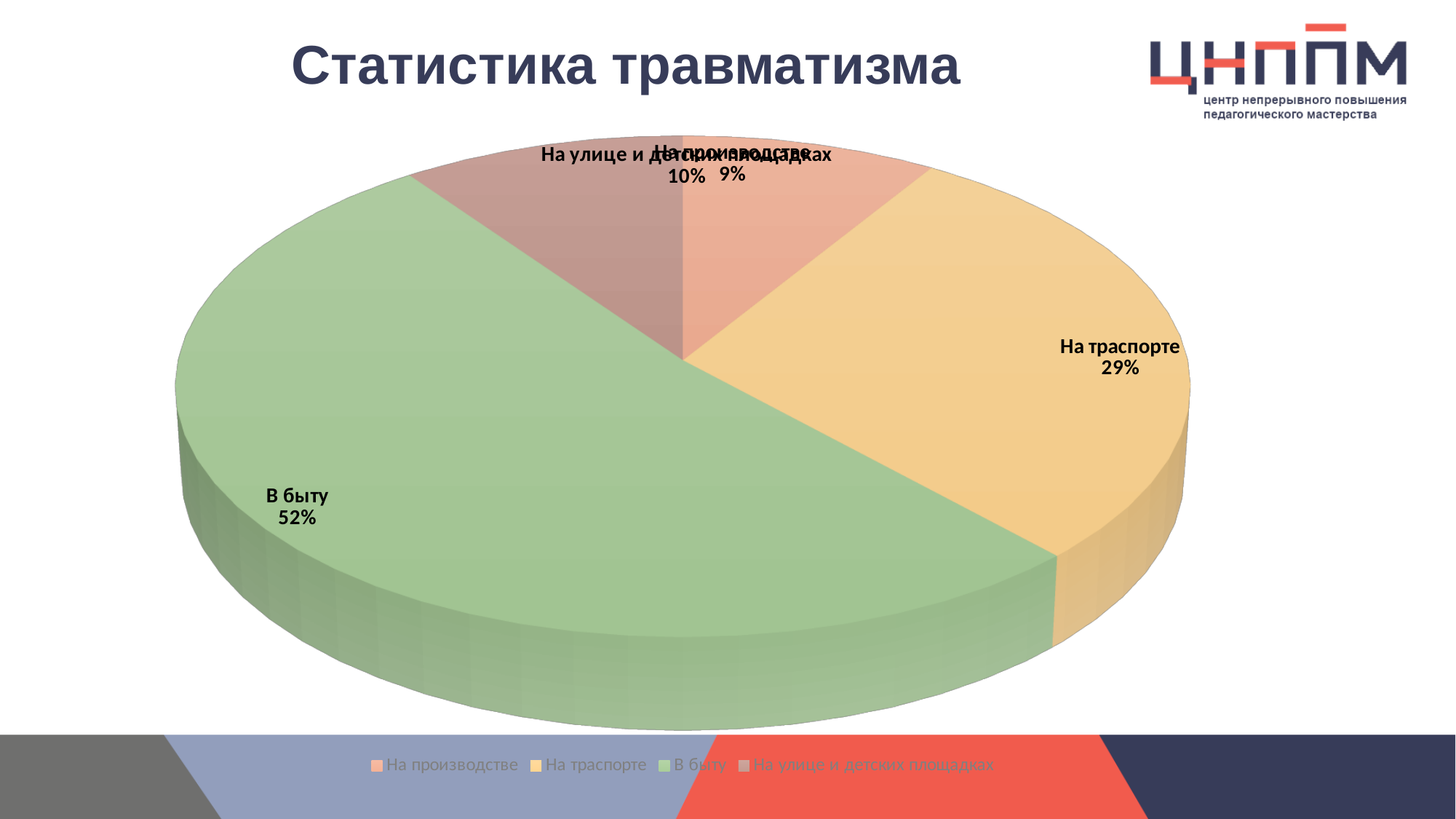
What kind of chart is shown on the slide? Pie chart What share of the pie does "На улице и детских площадках" take? 10% Which colour is used for the "В быту" slice? Green What is the title of the chart on the slide? Статистика травматизма Which category has the smallest share of the pie? На производстве How many slices does the pie chart have? 4 Which is larger, the share for "На траспорте" or the share for "На улице и детских площадках"? На траспорте Which category has the largest share of the pie? В быту What is the difference in percentage points between "В быту" and "На траспорте"? 23 What share of the pie does "В быту" take? 52% What share of the pie does "На траспорте" take? 29%